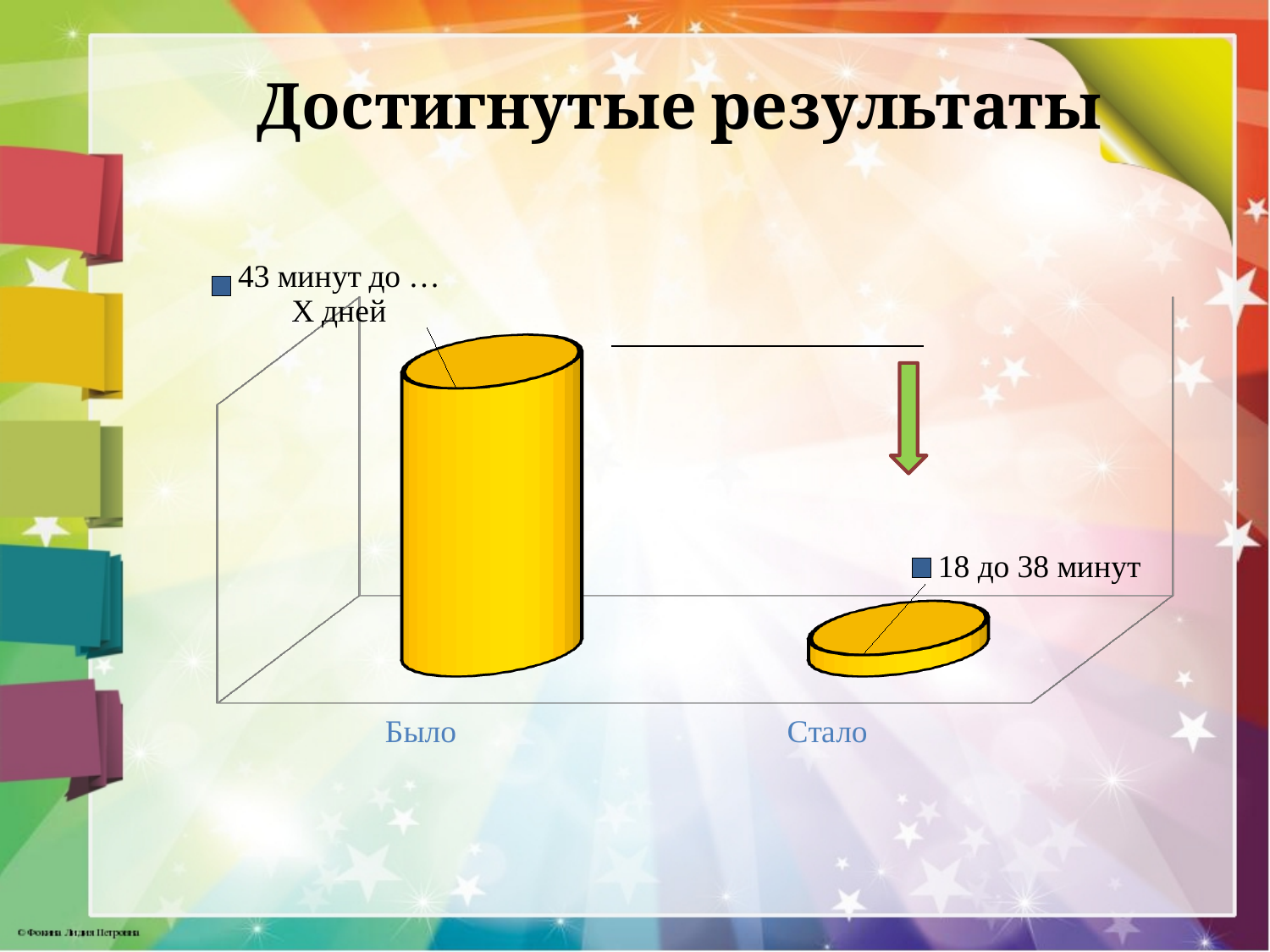
Which category has the lowest value in the chart? Стало What kind of chart is shown on the slide? bar chart What are the two category labels on the x axis of the chart? Было, Стало How many categories are shown on the x axis of the chart? 2 Which category has the highest value in the chart? Было Which category has the taller bar, Было or Стало? Было What is the title of the slide containing the chart? Достигнутые результаты What data label is attached to the bar for Стало? 18 до 38 минут Do the values rise or fall from Было to Стало? fall What data label is attached to the bar for Было? 43 минут до … Х дней